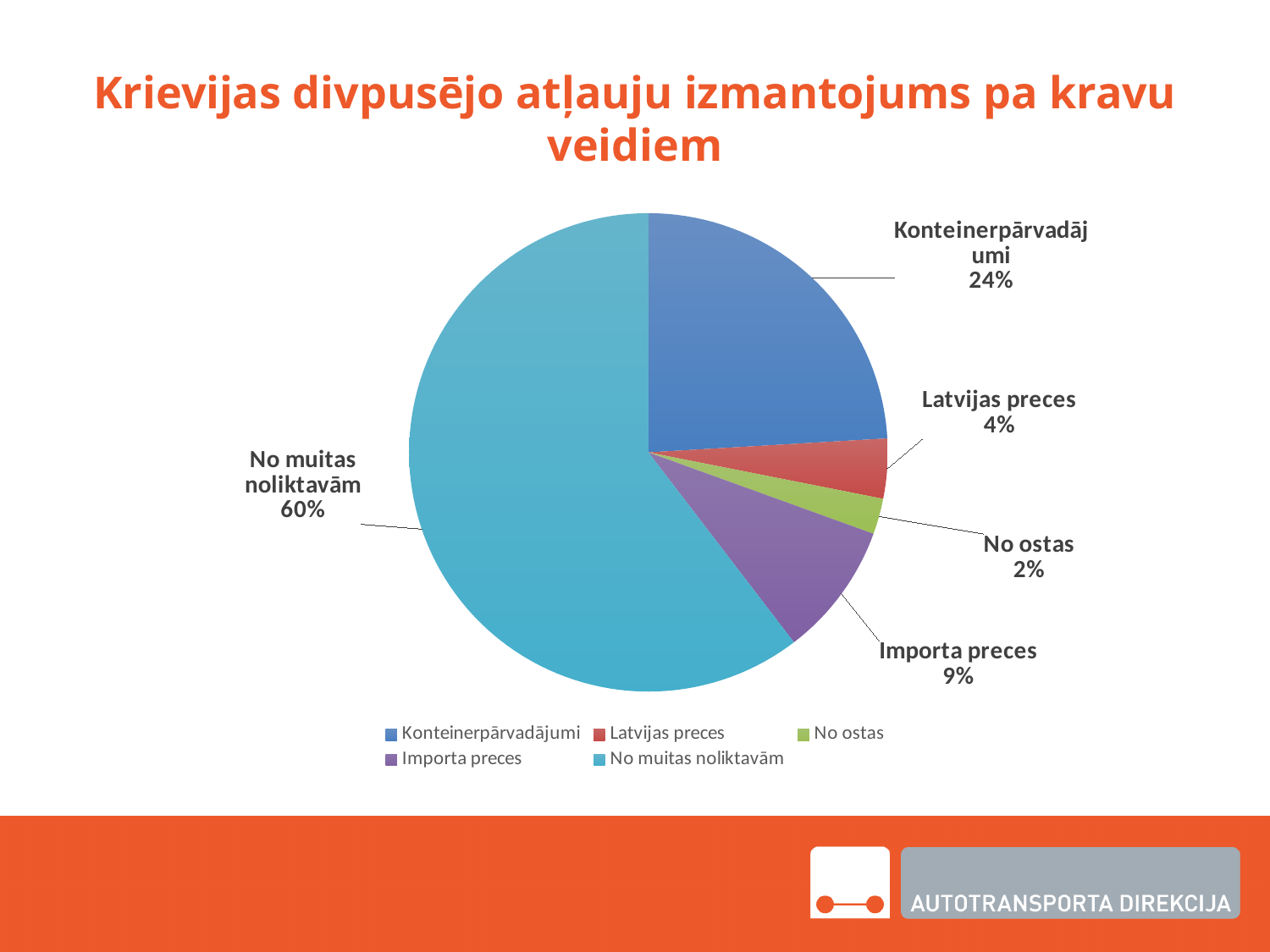
Which category has the largest slice of the pie? No muitas noliktavām What kind of chart is shown on the slide? pie chart What is the value shown for "Latvijas preces"? 4% How many categories does the pie chart have? 5 What share of the pie does "No muitas noliktavām" have? 60% What is the value shown for "Importa preces"? 9% What is the value shown for "Konteinerpārvadājumi"? 24% Which is larger, the share for "Latvijas preces" or the share for "Importa preces"? Importa preces What is the title of the chart on the slide? Krievijas divpusējo atļauju izmantojums pa kravu veidiem What is the difference between the shares of "Konteinerpārvadājumi" and "Importa preces"? 15% What is the value shown for "No ostas"? 2% Which category has the smallest slice of the pie? No ostas